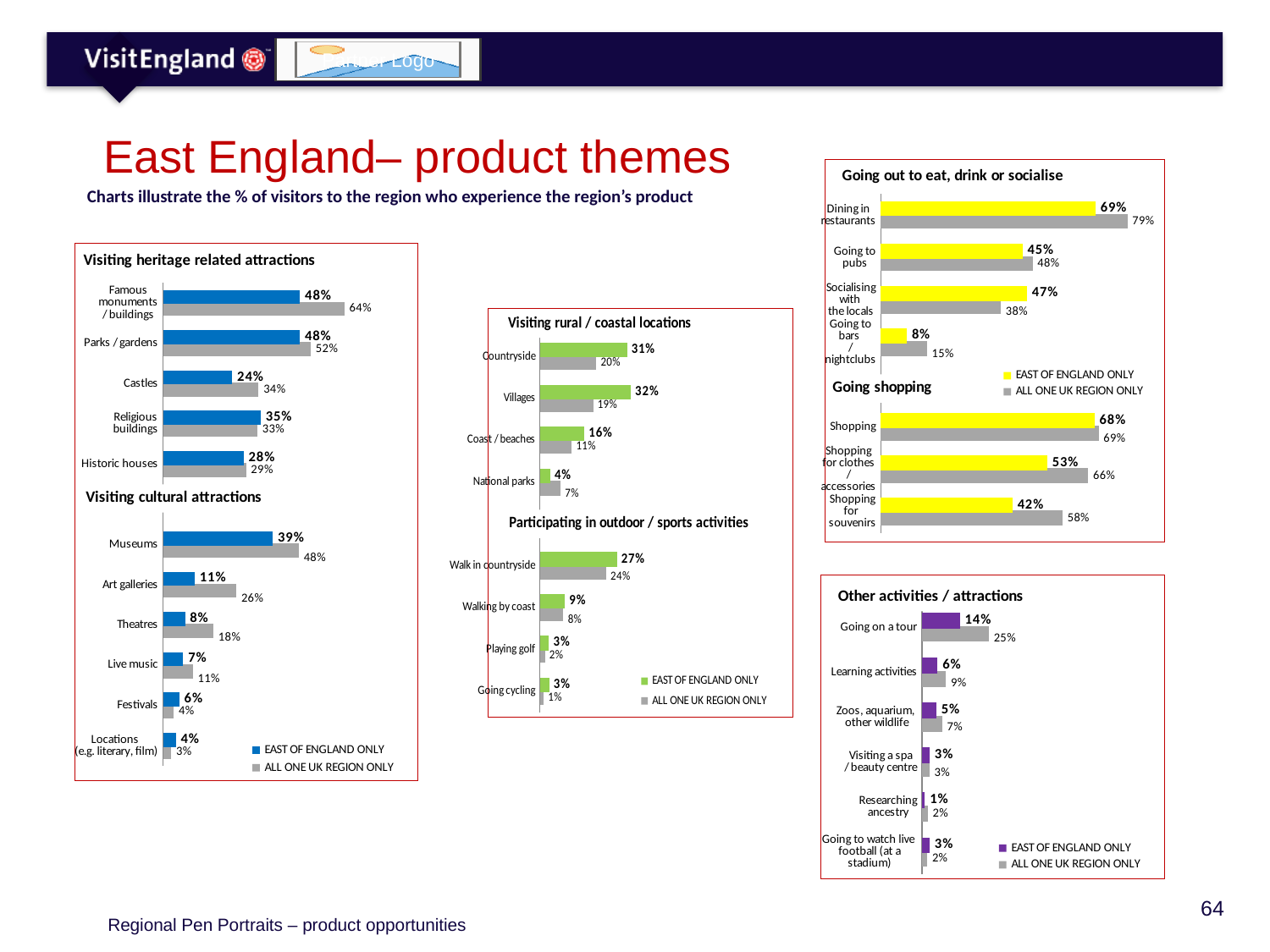
How many categories are shown in the 'Other activities / attractions' chart? 6 In the 'Visiting heritage related attractions' chart, what is the ALL ONE UK REGION ONLY value for Castles? 34% In the 'Going out to eat, drink or socialise' chart, what is the value for Dining in restaurants for EAST OF ENGLAND ONLY? 69% In the 'Other activities / attractions' chart, what is the EAST OF ENGLAND ONLY value for Going on a tour? 14% How many series does the legend list in the 'Participating in outdoor / sports activities' chart? 2 In the 'Going shopping' chart, what is the difference between the ALL ONE UK REGION ONLY and EAST OF ENGLAND ONLY values for Shopping for souvenirs? 16% In the 'Visiting rural / coastal locations' chart, which category has the lowest EAST OF ENGLAND ONLY value? National parks In the 'Participating in outdoor / sports activities' chart, what is the ALL ONE UK REGION ONLY value for Going cycling? 1% In the 'Visiting cultural attractions' chart, which category has the highest EAST OF ENGLAND ONLY value? Museums What type of chart is 'Visiting rural / coastal locations'? Bar chart In the 'Going out to eat, drink or socialise' chart, which is larger for Socialising with the locals: EAST OF ENGLAND ONLY or ALL ONE UK REGION ONLY? EAST OF ENGLAND ONLY What colour are the EAST OF ENGLAND ONLY bars in the 'Going shopping' chart? Yellow